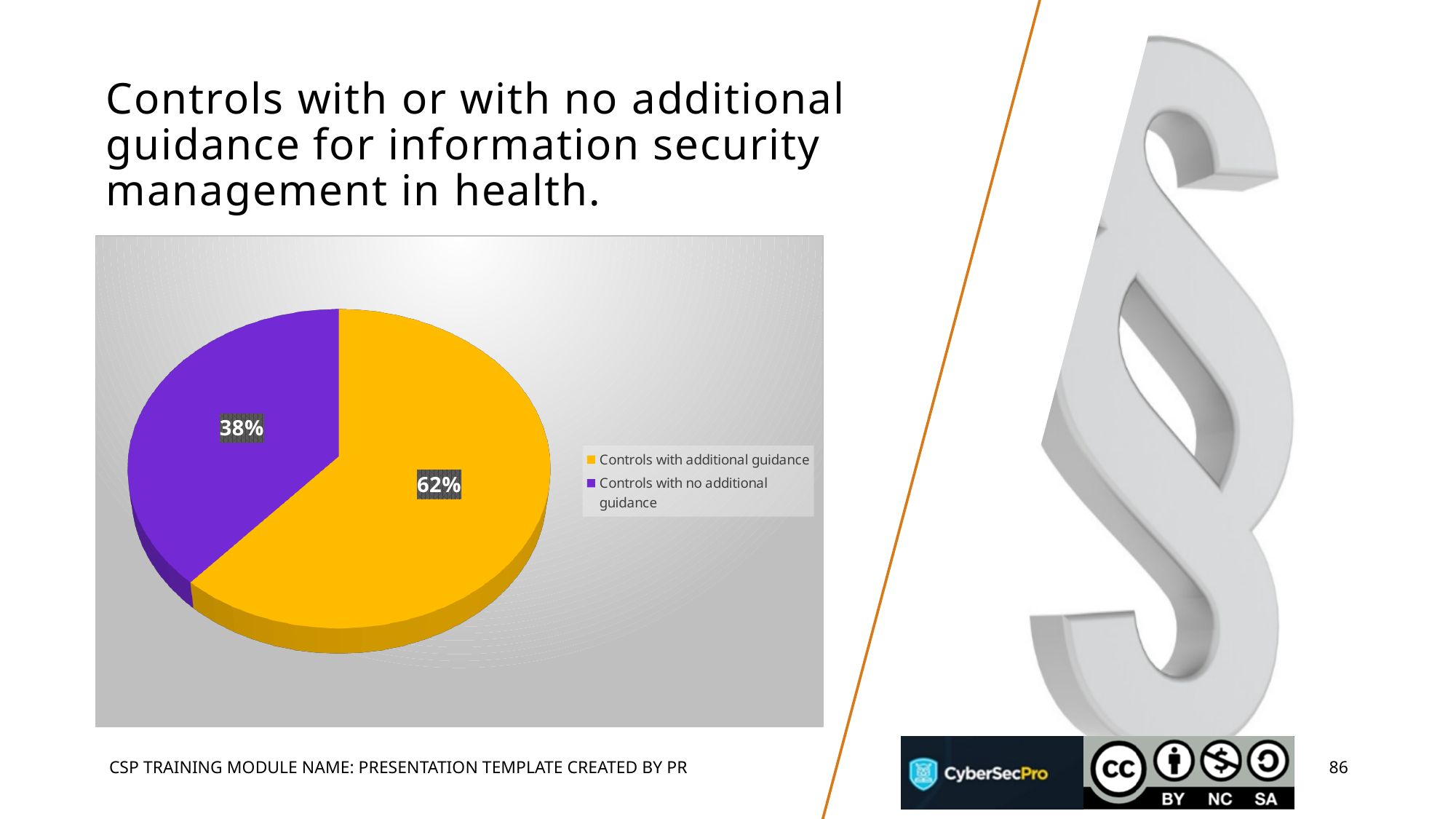
What is the difference in percentage points between 'Controls with additional guidance' and 'Controls with no additional guidance'? 24% What share of the pie is 'Controls with additional guidance'? 62% What kind of chart is shown on the slide? Pie chart How many entries does the legend list? 2 Which is larger: the slice for 'Controls with additional guidance' or the slice for 'Controls with no additional guidance'? Controls with additional guidance Which category has the smallest slice of the pie? Controls with no additional guidance What colour is the slice for 'Controls with no additional guidance'? Purple Which category has the largest slice of the pie? Controls with additional guidance What share of the pie is 'Controls with no additional guidance'? 38% What colour is the slice for 'Controls with additional guidance'? Yellow How many slices does the pie chart have? 2